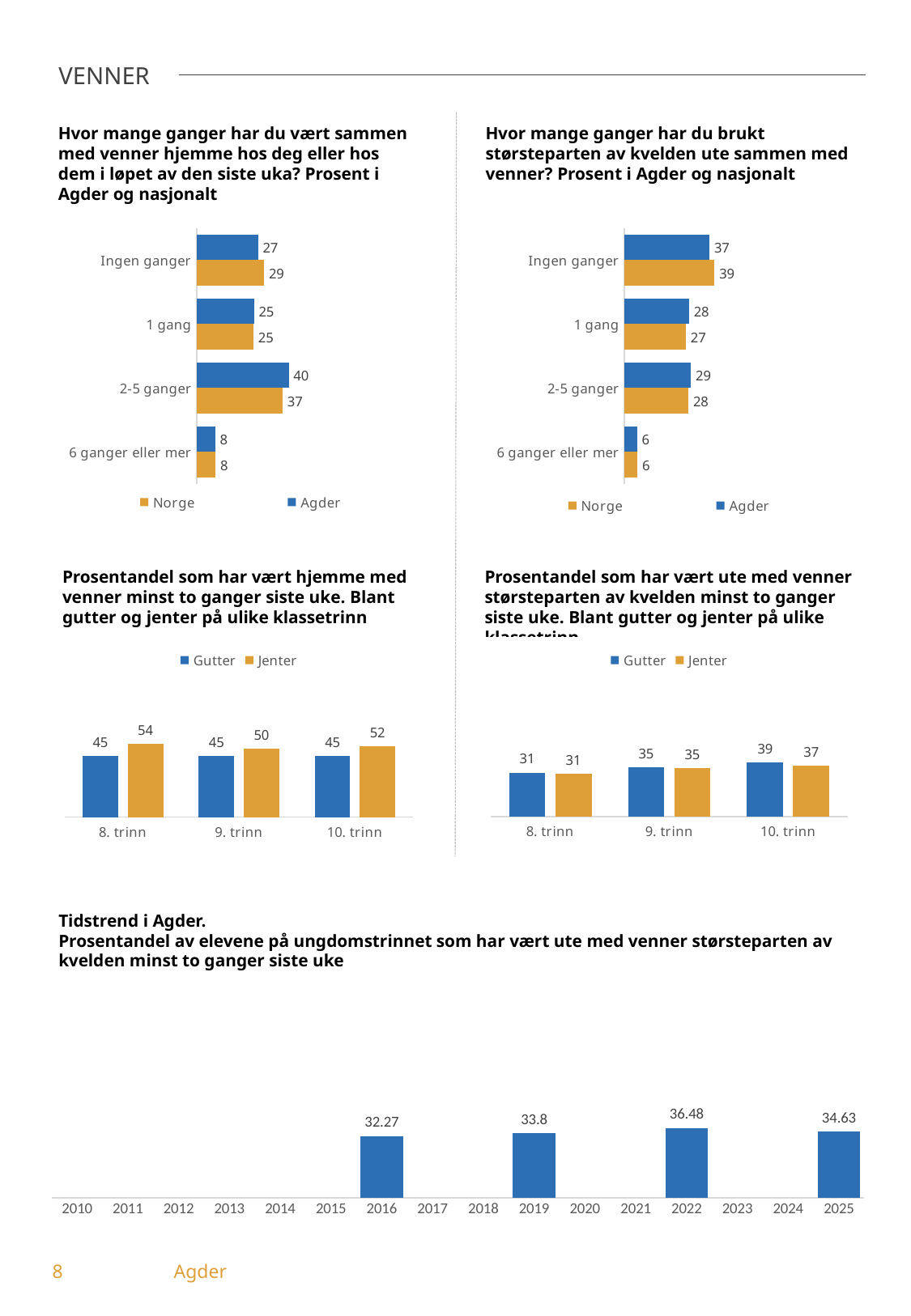
In the top-left chart (venner hjemme hos deg eller hos dem), what is the value for Norge in the 'Ingen ganger' category? 29 In the bottom chart (Tidstrend i Agder), which year has the lowest value? 2016 In the top-right chart (størsteparten av kvelden ute sammen med venner), what is the value for Agder in the '1 gang' category? 28 In the top-right chart (størsteparten av kvelden ute sammen med venner), which category has the highest value for Norge? Ingen ganger In the top-right chart (størsteparten av kvelden ute sammen med venner), which category has the lowest value for Agder? 6 ganger eller mer In the middle-right chart (ute med venner størsteparten av kvelden, gutter og jenter), how many series does the legend list? 2 In the middle-left chart (hjemme med venner minst to ganger, gutter og jenter), which is larger in 9. trinn: Gutter or Jenter? Jenter In the bottom chart (Tidstrend i Agder), what is the value for 2022? 36.48 In the middle-right chart (ute med venner størsteparten av kvelden, gutter og jenter), what is the value for Gutter in 10. trinn? 39 In the top-left chart (venner hjemme hos deg eller hos dem), what is the difference between Agder and Norge for '2-5 ganger'? 3 In the middle-left chart (hjemme med venner minst to ganger, gutter og jenter), what is the value for Jenter in 8. trinn? 54 In the top-left chart (venner hjemme hos deg eller hos dem), what is the value for Agder in the '2-5 ganger' category? 40